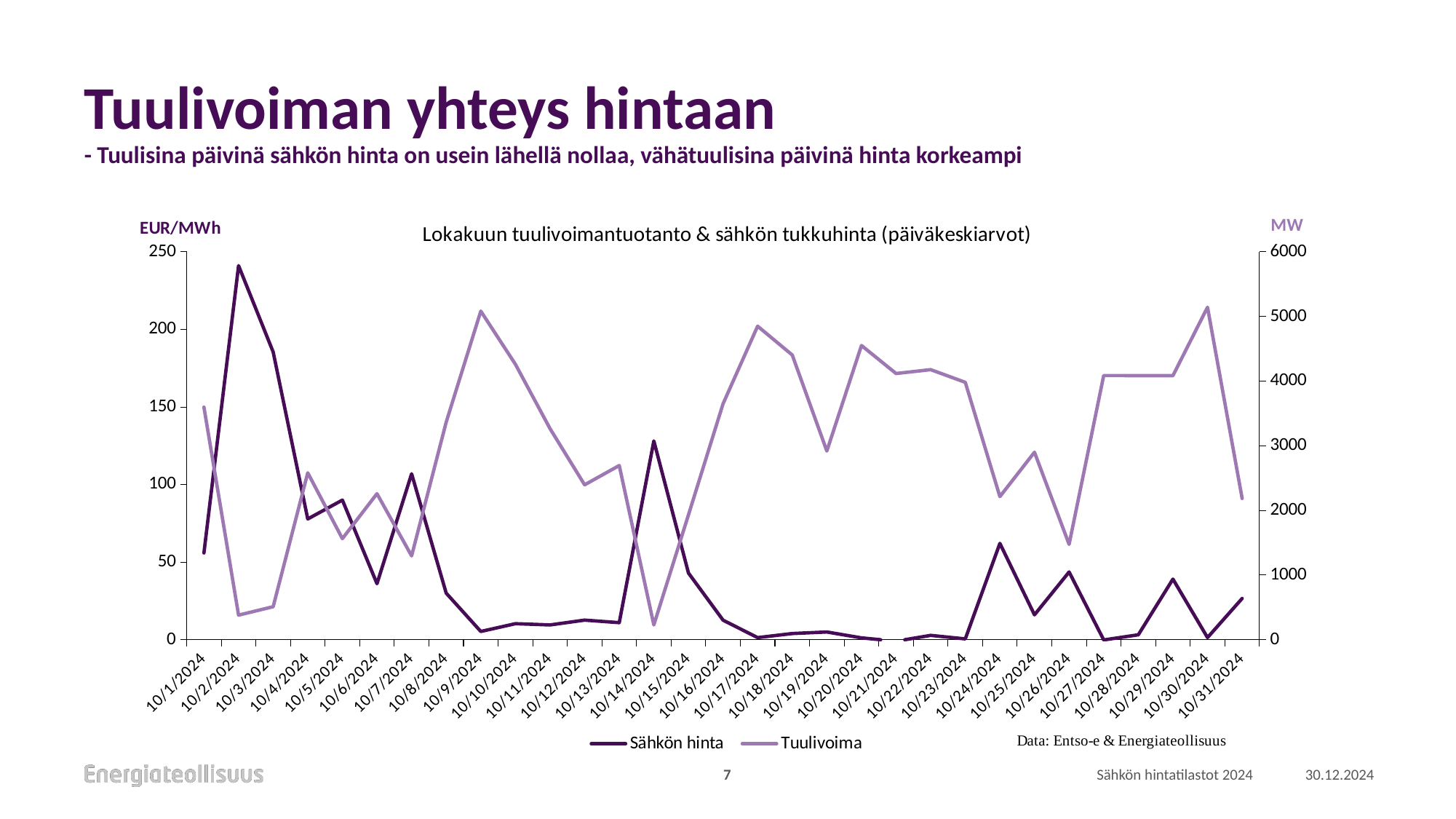
Is the Tuulivoima value for 10/17/2024 greater or less than 4000? greater What kind of chart is shown on the slide? line chart On which date is the Sähkön hinta value highest? 10/2/2024 Which is larger, the Sähkön hinta value for 10/2/2024 or for 10/3/2024? 10/2/2024 How many dates are plotted along the x axis? 31 What unit is shown on the left vertical axis? EUR/MWh Does the Sähkön hinta series rise or fall from 10/2/2024 to 10/9/2024? fall Is the Sähkön hinta value for 10/14/2024 greater or less than 100? greater On which date is the Tuulivoima value lowest? 10/14/2024 How many series does the legend list? 2 Is the Tuulivoima value for 10/2/2024 greater or less than 1000? less